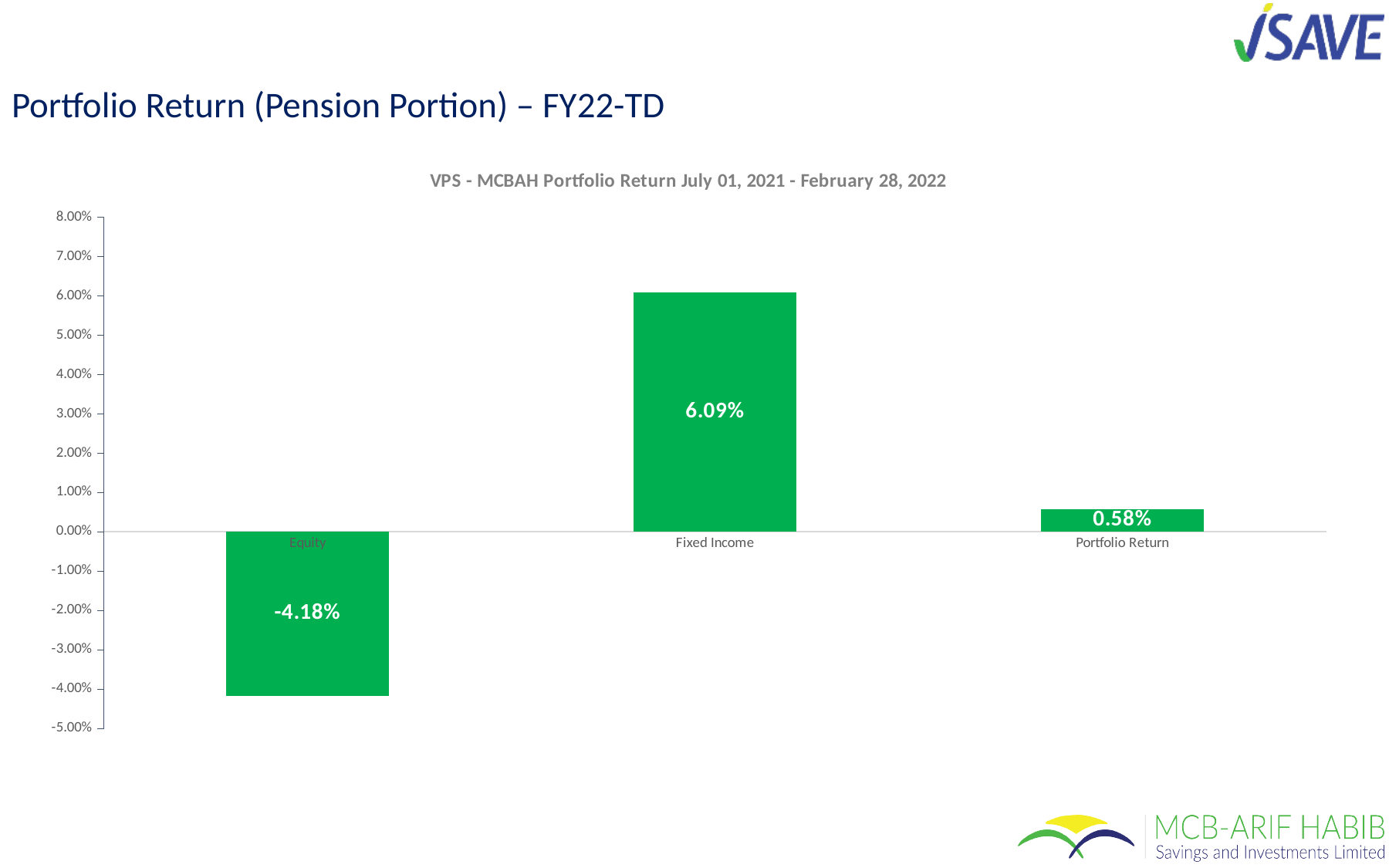
What is the title of the chart? VPS - MCBAH Portfolio Return July 01, 2021 - February 28, 2022 What is the value for Equity? -4.18% What is the value for Fixed Income? 6.09% How many categories are shown on the chart? 3 What is the difference between the Fixed Income value and the Portfolio Return value? 5.51% Which category has the highest value? Fixed Income What is the value for Portfolio Return? 0.58% What kind of chart is shown on the slide? Bar chart Is the value for Equity greater or less than -3.00%? less Which is larger, the value for Equity or the value for Portfolio Return? Portfolio Return Is the value for Fixed Income greater or less than 5.00%? greater Which category has the lowest value? Equity